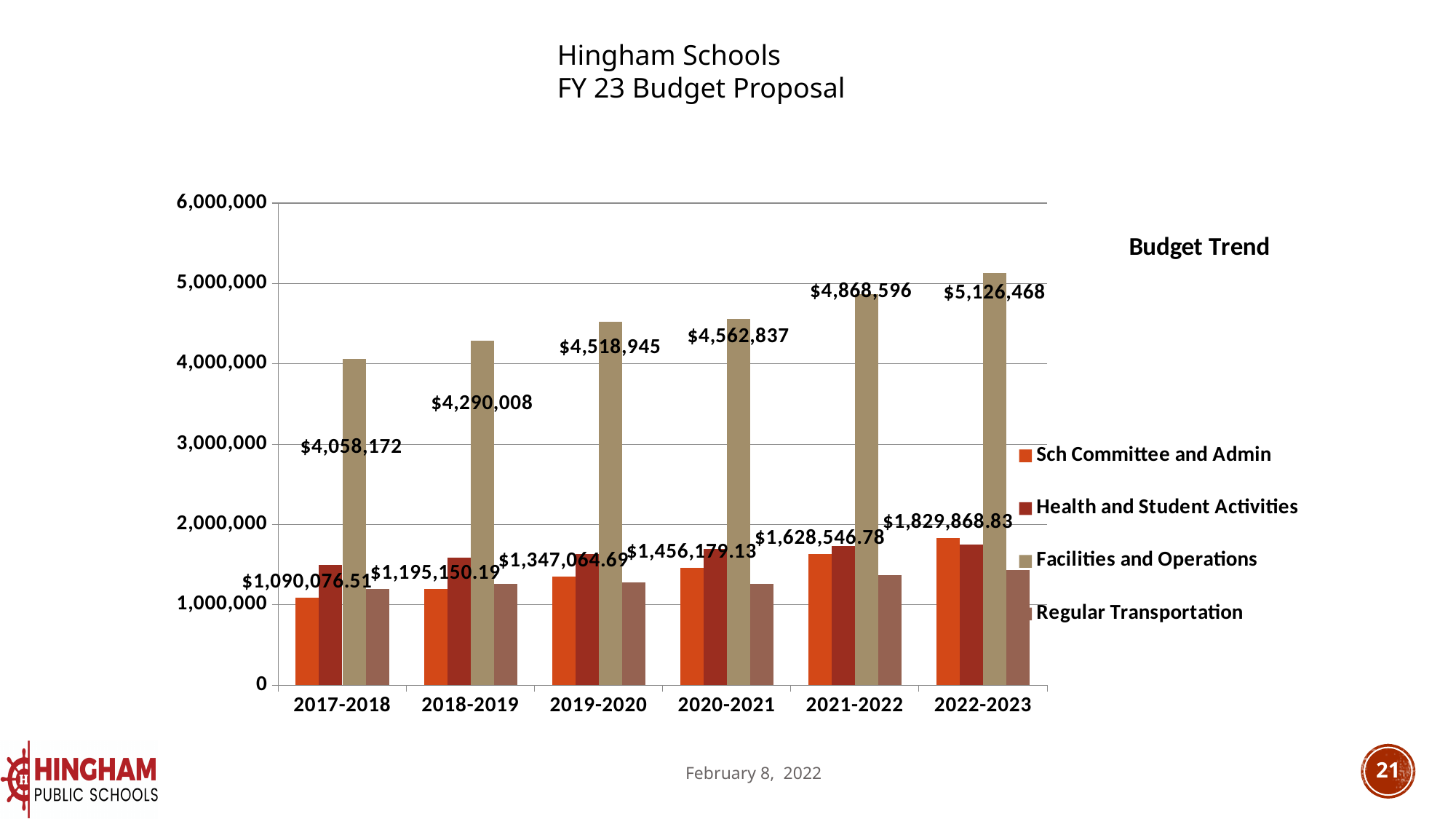
What kind of chart is shown on the slide? bar chart In which year is the Sch Committee and Admin value lowest? 2017-2018 Do the Facilities and Operations values rise or fall from 2017-2018 to 2022-2023? rise What is the value for Facilities and Operations in 2022-2023? $5,126,468 How many years are shown on the x axis? 6 In which year is the Facilities and Operations value highest? 2022-2023 What is the difference between the Facilities and Operations values for 2022-2023 and 2021-2022? $257,872 What is the value for Sch Committee and Admin in 2017-2018? $1,090,076.51 What is the value for Sch Committee and Admin in 2020-2021? $1,456,179.13 Which is larger for Facilities and Operations: 2019-2020 or 2020-2021? 2020-2021 Is the value for Health and Student Activities in 2022-2023 greater or less than 2,000,000? less How many series does the legend list? 4